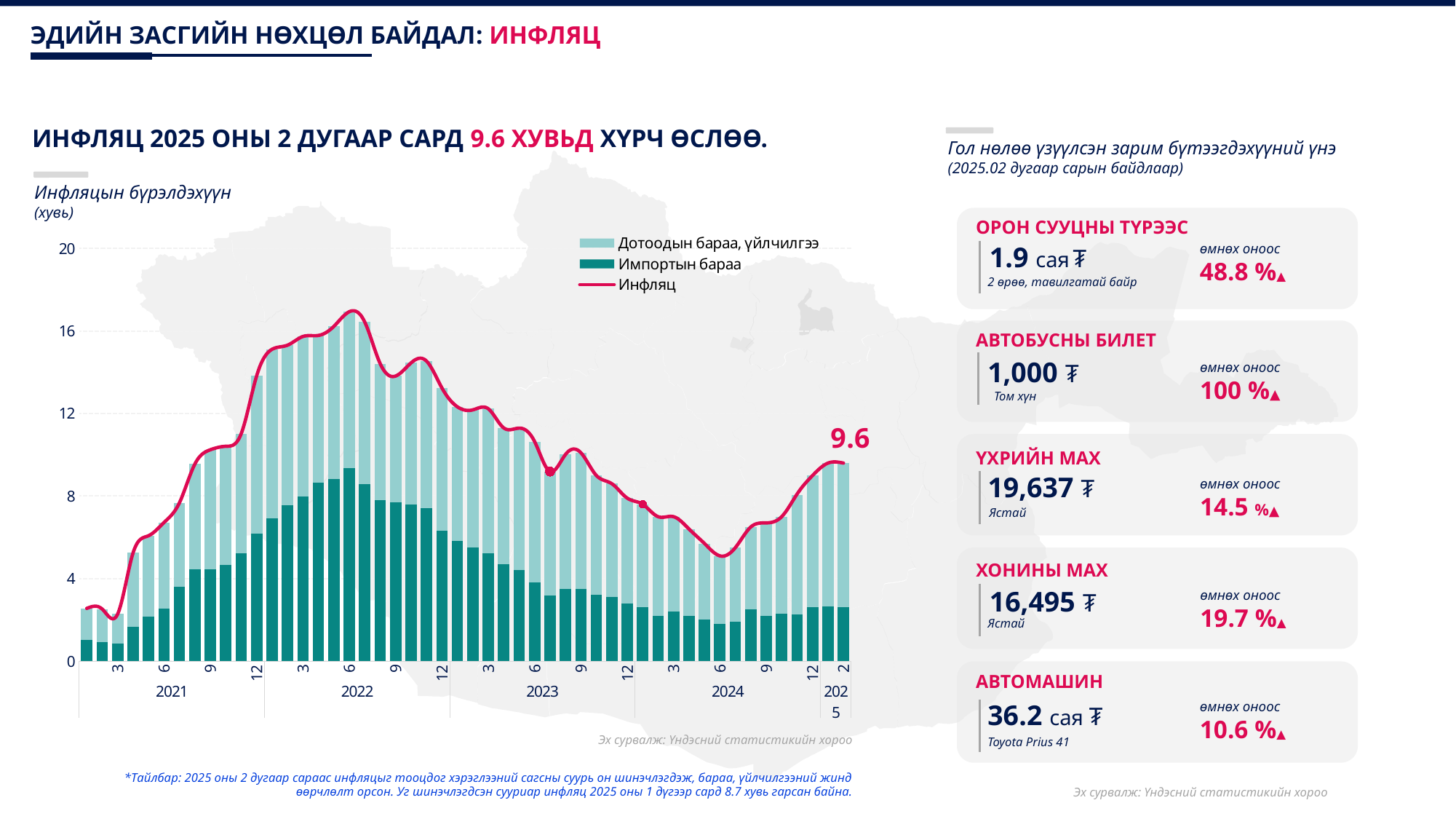
Is the inflation line value in March 2021 greater or less than 4? less Does the inflation line rise or fall between June 2022 and June 2024? fall What is the title of the chart on the left? Инфляцын бүрэлдэхүүн (хувь) How many series does the chart legend list? 3 Which legend entry is shown as a line rather than a bar? Инфляц What inflation value is labelled at the end of the line for February 2025? 9.6 Is the inflation line value in June 2024 greater or less than 8? less What kind of chart is used to show the inflation components? bar chart (stacked) with a line Which is larger, the imported goods (Импортын бараа) bar in June 2022 or in June 2024? June 2022 In which year does the inflation line reach its highest point? 2022 Is the inflation line value in June 2022 greater or less than 16? greater Does the inflation line rise or fall between June 2024 and February 2025? rise